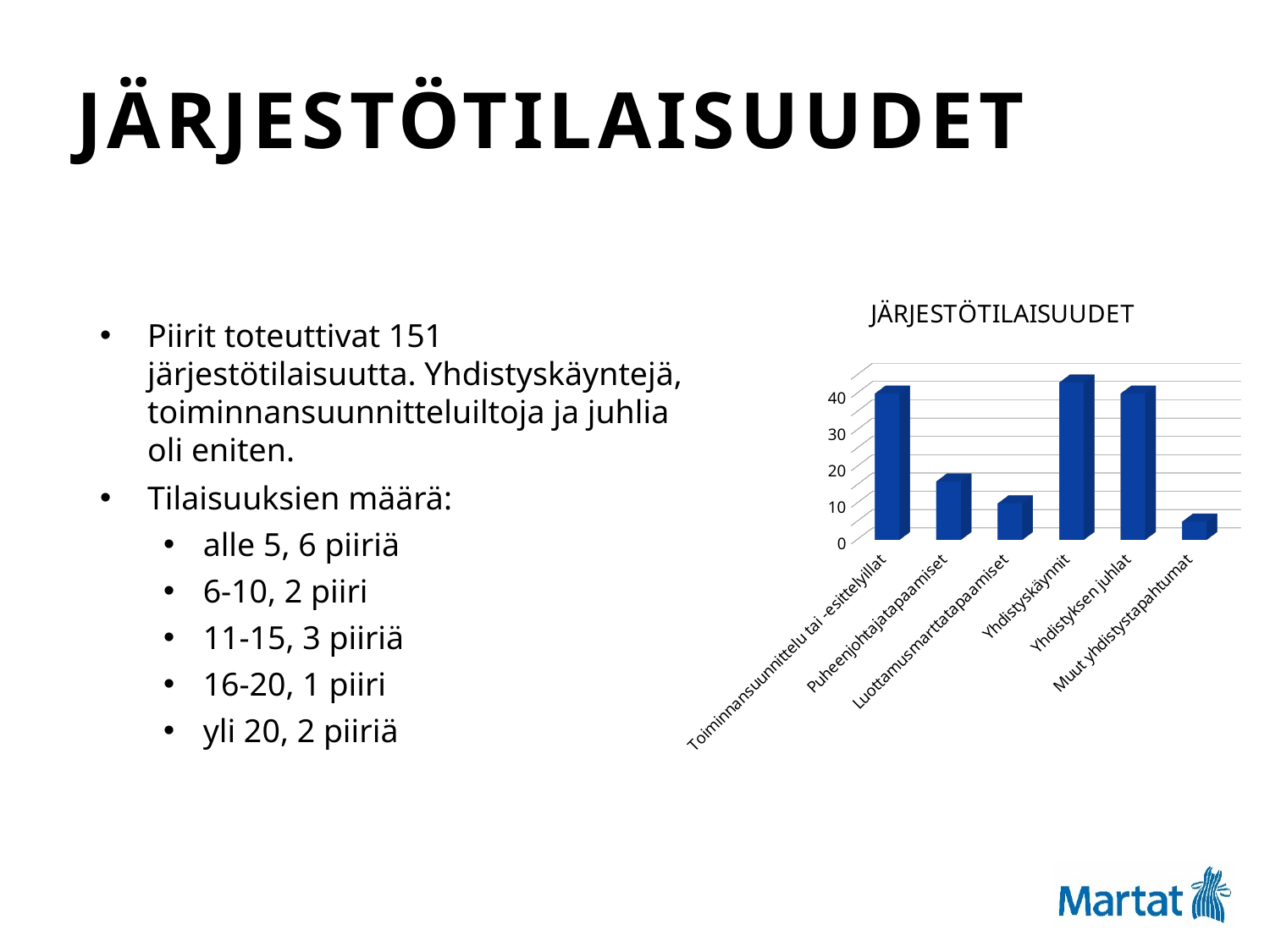
Is the value for Muut yhdistystapahtumat greater or less than 10? less Is the value for Toiminnansuunnittelu tai -esittelyillat greater or less than 30? greater Is the value for Puheenjohtajatapaamiset greater or less than 20? less How many categories are shown on the chart's x axis? 6 Which category has the lowest value in the chart? Muut yhdistystapahtumat What is the title of the chart? JÄRJESTÖTILAISUUDET What kind of chart is shown on the slide? bar chart Which is larger, the value for Yhdistyskäynnit or the value for Luottamusmarttatapaamiset? Yhdistyskäynnit Which category has the highest value in the chart? Yhdistyskäynnit Which is larger, the value for Puheenjohtajatapaamiset or the value for Muut yhdistystapahtumat? Puheenjohtajatapaamiset